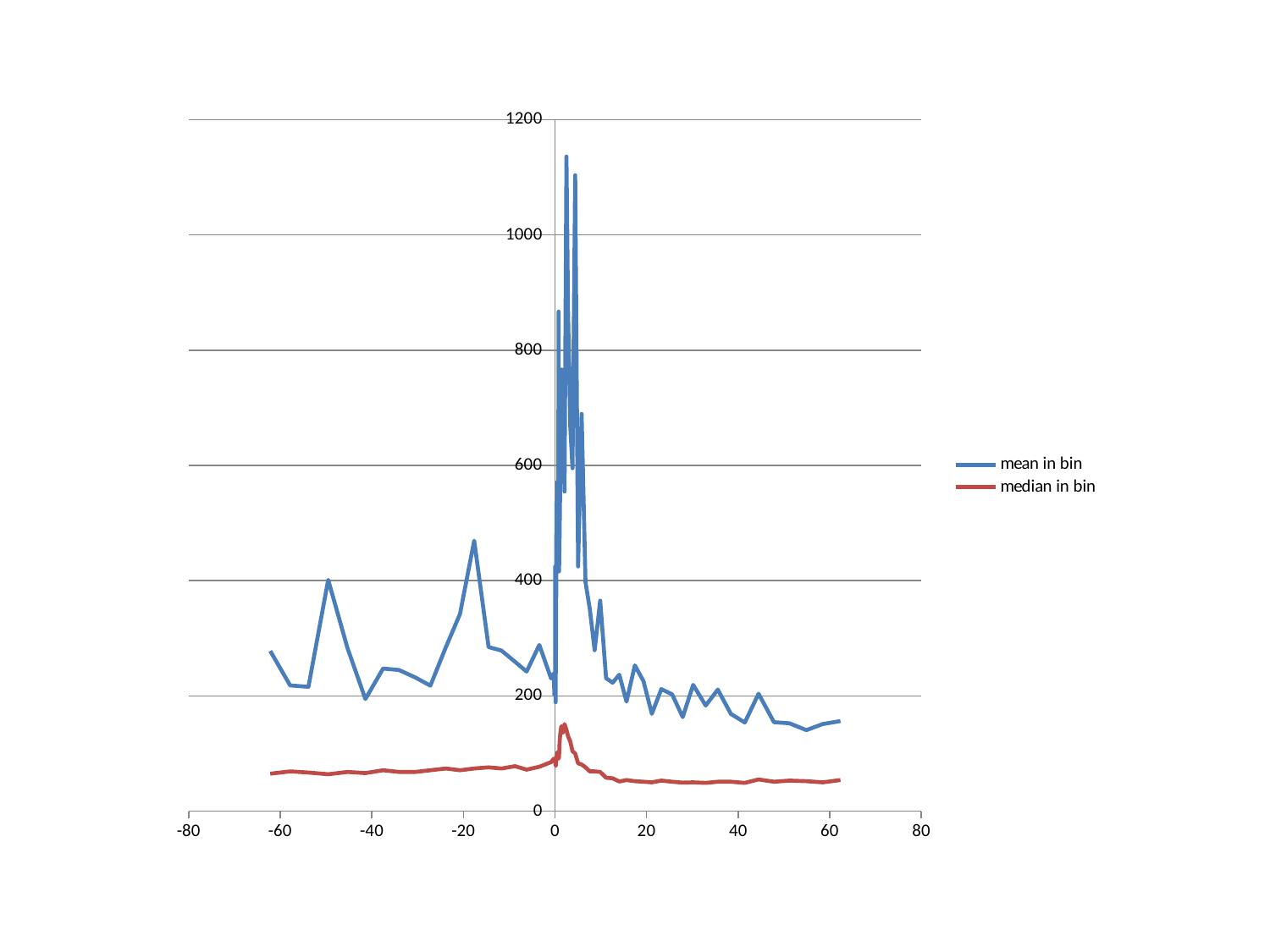
At x = 60, is the "mean in bin" value greater or less than 200? less Which series reaches the higher maximum value, "mean in bin" or "median in bin"? mean in bin Which colour is used for the "median in bin" series? red What is the highest value shown on the vertical axis? 1200 Is the highest value of the "median in bin" series greater or less than 200? less Is the peak value of the "mean in bin" series greater or less than 1000? greater What kind of chart is shown on the slide? line chart How many series does the legend list? 2 What are the two series named in the legend? mean in bin, median in bin Near which x value does the "mean in bin" series reach its highest point: around 0 or around -20? around 0 Does the "mean in bin" series generally rise or fall as x increases from 10 to 60? fall